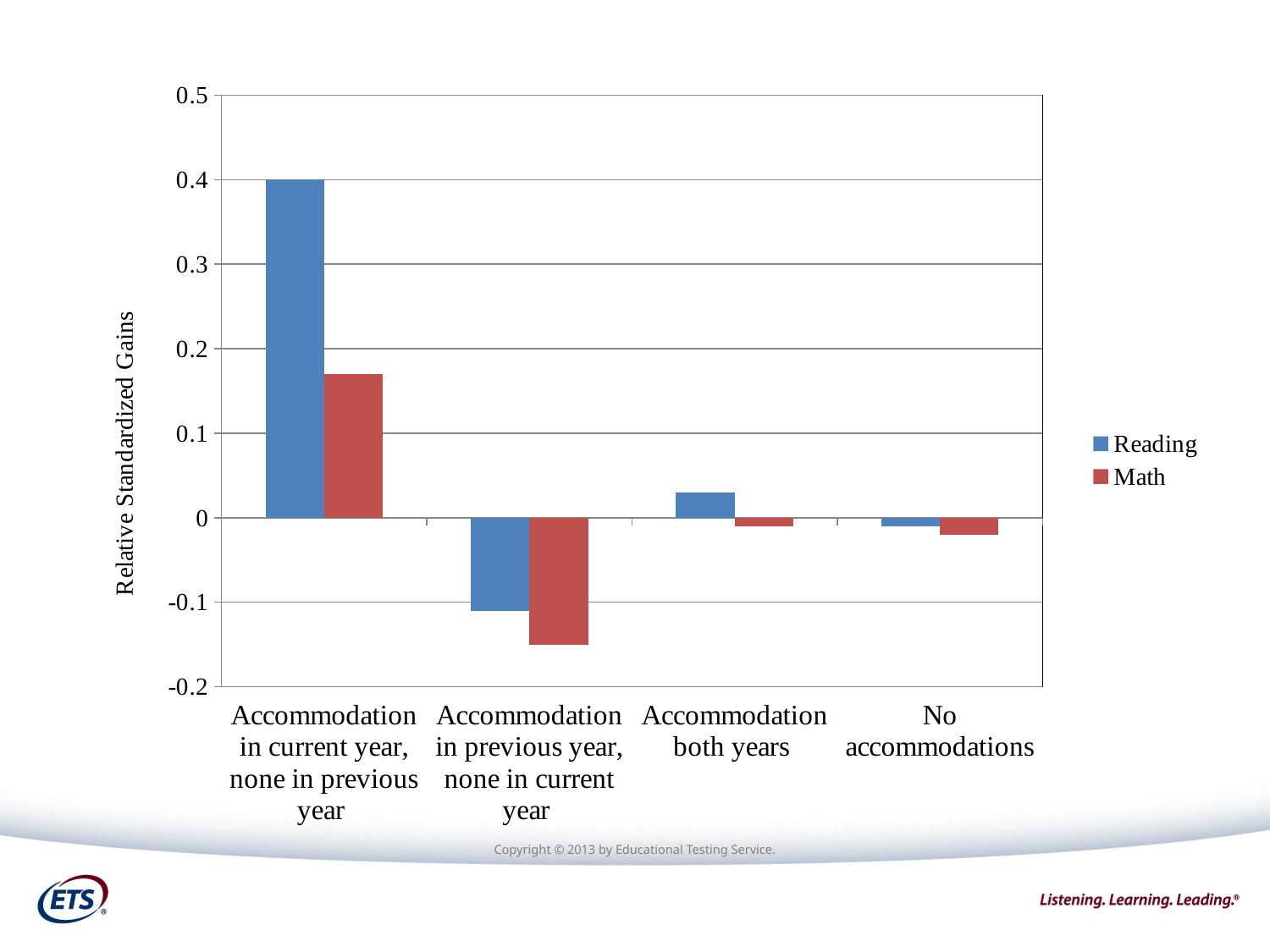
For "Accommodation in current year, none in previous year", which is larger, Reading or Math? Reading Which category has the highest Reading value? Accommodation in current year, none in previous year Is the Math value for "Accommodation in current year, none in previous year" greater or less than 0.2? less Is the Reading value for "Accommodation in previous year, none in current year" greater or less than -0.1? less What is the label of the vertical axis? Relative Standardized Gains What kind of chart is shown on the slide? bar chart How many categories are shown on the x axis? 4 How many series does the legend list? 2 Is the Math value for "Accommodation in previous year, none in current year" greater or less than -0.1? less For "Accommodation both years", which is larger, Reading or Math? Reading Which category has the lowest Math value? Accommodation in previous year, none in current year What is the Reading value for "Accommodation in current year, none in previous year"? 0.4